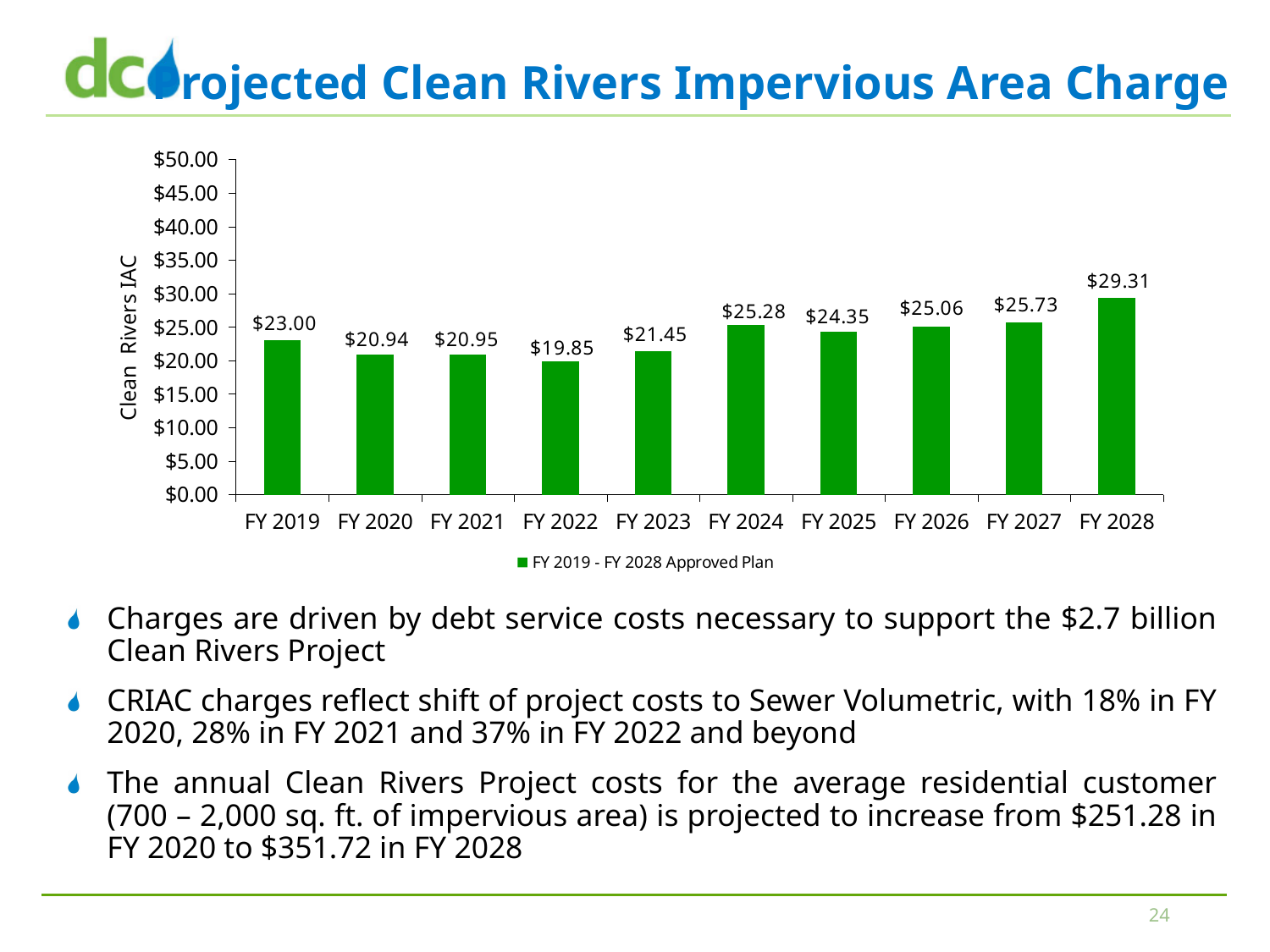
Which is larger, the Clean Rivers IAC for FY 2024 or for FY 2025? FY 2024 What is the difference between the Clean Rivers IAC in FY 2028 and FY 2027? $3.58 What is the Clean Rivers IAC value for FY 2022? $19.85 Is the value for FY 2026 greater or less than $20.00? greater Which fiscal year has the highest Clean Rivers IAC? FY 2028 How many fiscal years are shown on the x axis of the chart? 10 What is the legend entry for the series in the chart? FY 2019 - FY 2028 Approved Plan How many series does the chart legend list? 1 What is the Clean Rivers IAC value for FY 2019? $23.00 What type of chart is shown on the slide? Bar chart Which fiscal year has the lowest Clean Rivers IAC? FY 2022 What is the Clean Rivers IAC value for FY 2028? $29.31